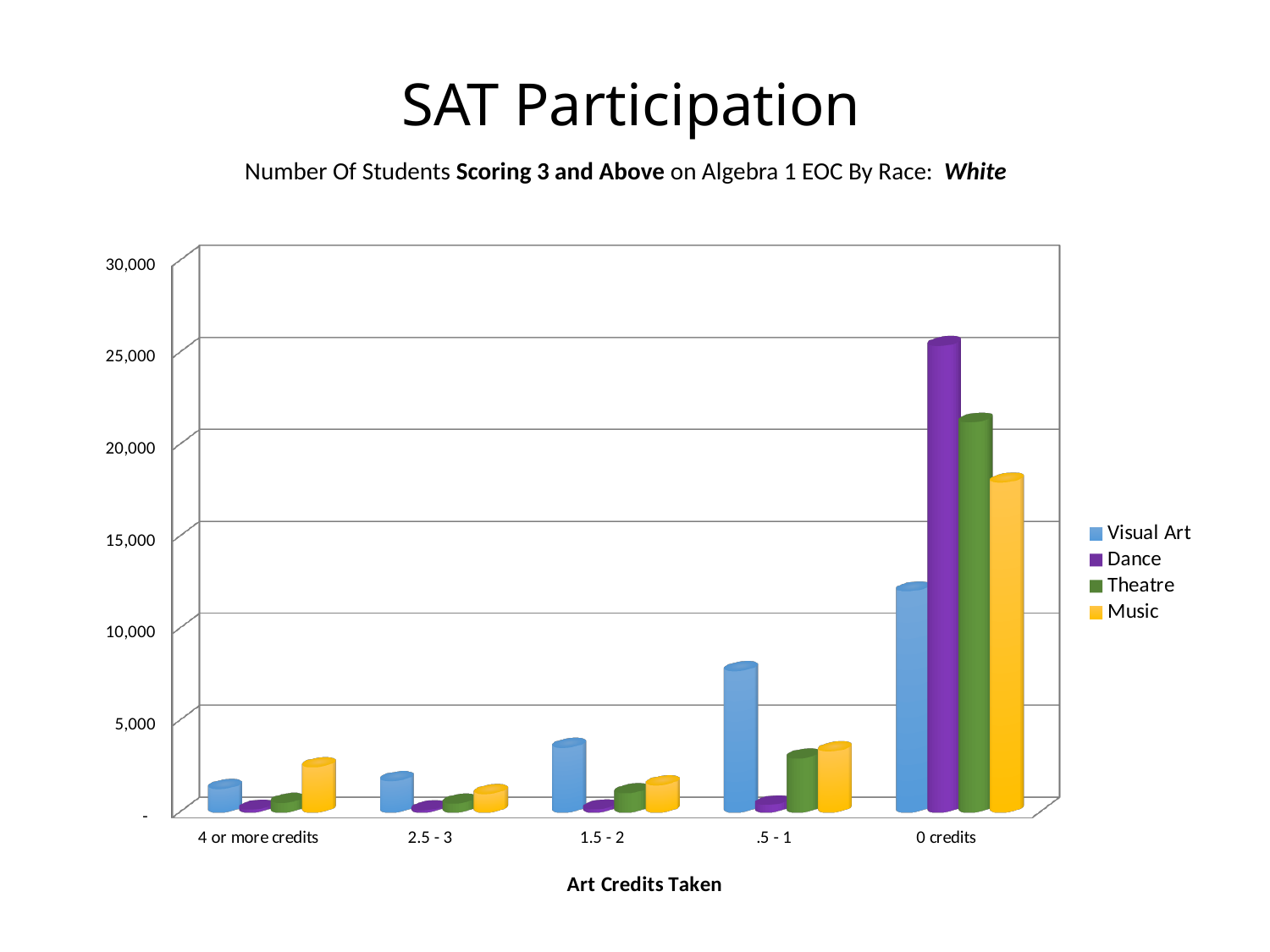
In the .5 - 1 category, which is larger: Visual Art or Theatre? Visual Art Which series has the shortest bar in the 0 credits category? Visual Art How many series does the legend list? 4 Do the Visual Art values rise or fall moving along the x axis from 4 or more credits to 0 credits? Rise What kind of chart is shown on the slide? Bar chart Is the value for Dance at 0 credits greater or less than 20,000? greater Is the value for Visual Art at .5 - 1 credits greater or less than 5,000? greater Is the value for Visual Art at 0 credits greater or less than 15,000? less What is the title of the x axis? Art Credits Taken How many art-credit categories are shown on the x axis? 5 Which series has the tallest bar in the 0 credits category? Dance In the 0 credits category, which is larger: Dance or Music? Dance